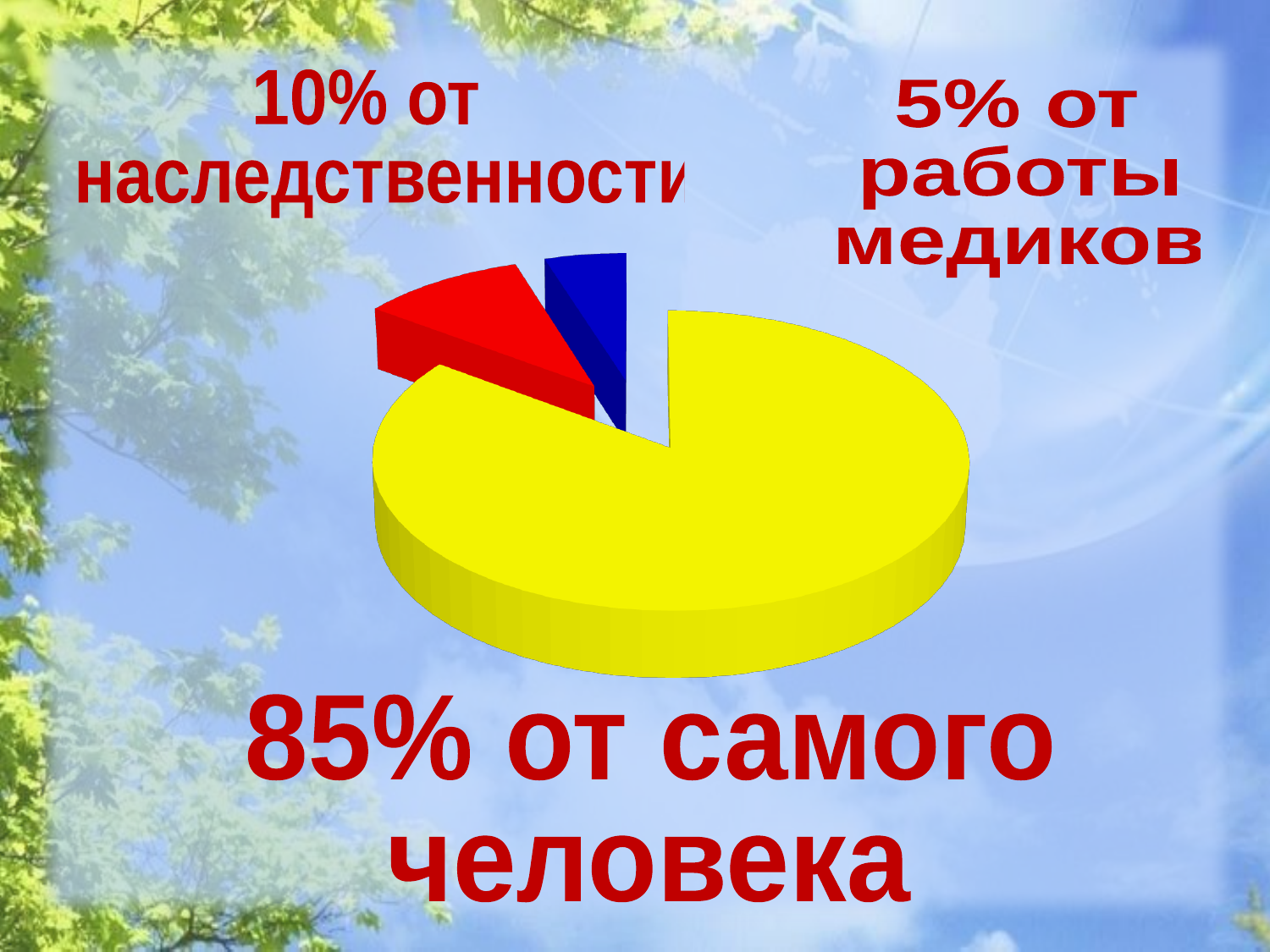
What share of the pie is attributed to the person themselves (от самого человека)? 85% What colour is the largest slice of the pie? yellow What share of the pie is attributed to the work of medics (от работы медиков)? 5% What is the difference in percentage points between the heredity slice and the medics slice? 5% How many slices does the pie chart have? 3 Which is larger: the heredity slice or the medics slice? heredity (от наследственности) What is the difference in percentage points between the largest slice and the heredity slice? 75% What share of the pie is attributed to heredity (от наследственности)? 10% What colour is the slice labelled 5% от работы медиков? blue What kind of chart is shown on the slide? pie chart Which category has the largest slice of the pie? от самого человека Which category has the smallest slice of the pie? от работы медиков